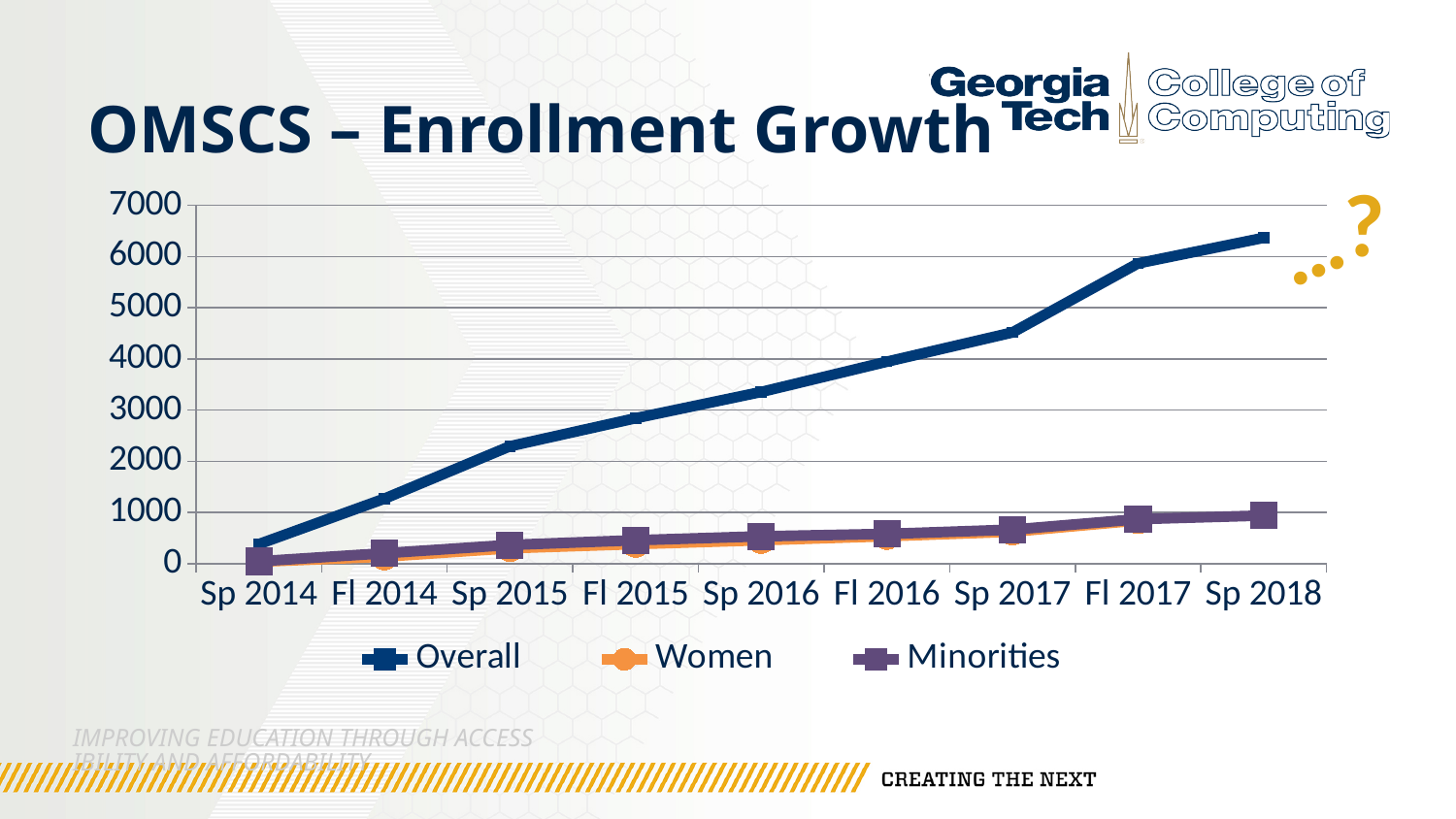
At Sp 2018, which series has the larger value, Overall or Minorities? Overall What is the title of the chart? OMSCS – Enrollment Growth At which time point is the Overall series lowest? Sp 2014 At which time point is the Overall series highest? Sp 2018 How many time points are plotted along the x axis? 9 What kind of chart is shown on the slide? line chart Which series are listed in the legend? Overall, Women, Minorities Is the Overall value for Sp 2017 greater or less than 5000? less How many series does the legend list? 3 Is the Minorities value for Sp 2018 greater or less than 2000? less Does the Overall series rise or fall from Sp 2014 to Sp 2018? rise Is the Overall value for Sp 2018 greater or less than 6000? greater